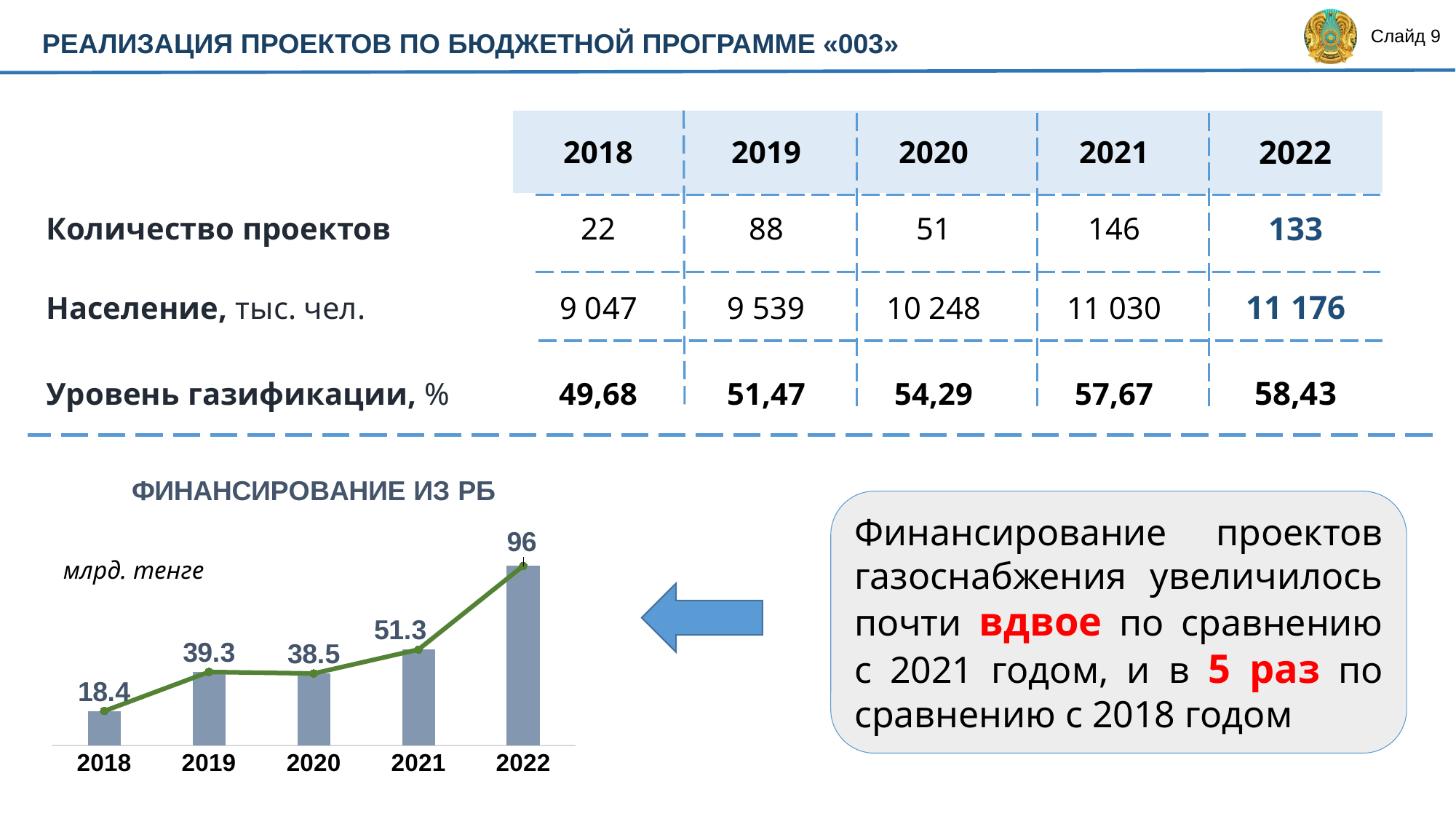
In the chart 'ФИНАНСИРОВАНИЕ ИЗ РБ', what is the difference between the values for 2022 and 2021? 44.7 In the chart 'ФИНАНСИРОВАНИЕ ИЗ РБ', which year has the lowest value? 2018 How many years are shown on the x axis of the chart 'ФИНАНСИРОВАНИЕ ИЗ РБ'? 5 What kind of chart is 'ФИНАНСИРОВАНИЕ ИЗ РБ'? Bar chart with a line overlay In the chart 'ФИНАНСИРОВАНИЕ ИЗ РБ', which is larger, the value for 2019 or the value for 2020? 2019 In the chart 'ФИНАНСИРОВАНИЕ ИЗ РБ', what is the value for 2022? 96 In the chart 'ФИНАНСИРОВАНИЕ ИЗ РБ', what is the value for 2018? 18.4 In the chart 'ФИНАНСИРОВАНИЕ ИЗ РБ', what is the value for 2021? 51.3 In the chart 'ФИНАНСИРОВАНИЕ ИЗ РБ', which year has the highest value? 2022 In the chart 'ФИНАНСИРОВАНИЕ ИЗ РБ', what is the value for 2020? 38.5 In the chart 'ФИНАНСИРОВАНИЕ ИЗ РБ', what is the difference between the values for 2019 and 2018? 20.9 What unit is indicated for the values in the chart 'ФИНАНСИРОВАНИЕ ИЗ РБ'? млрд. тенге